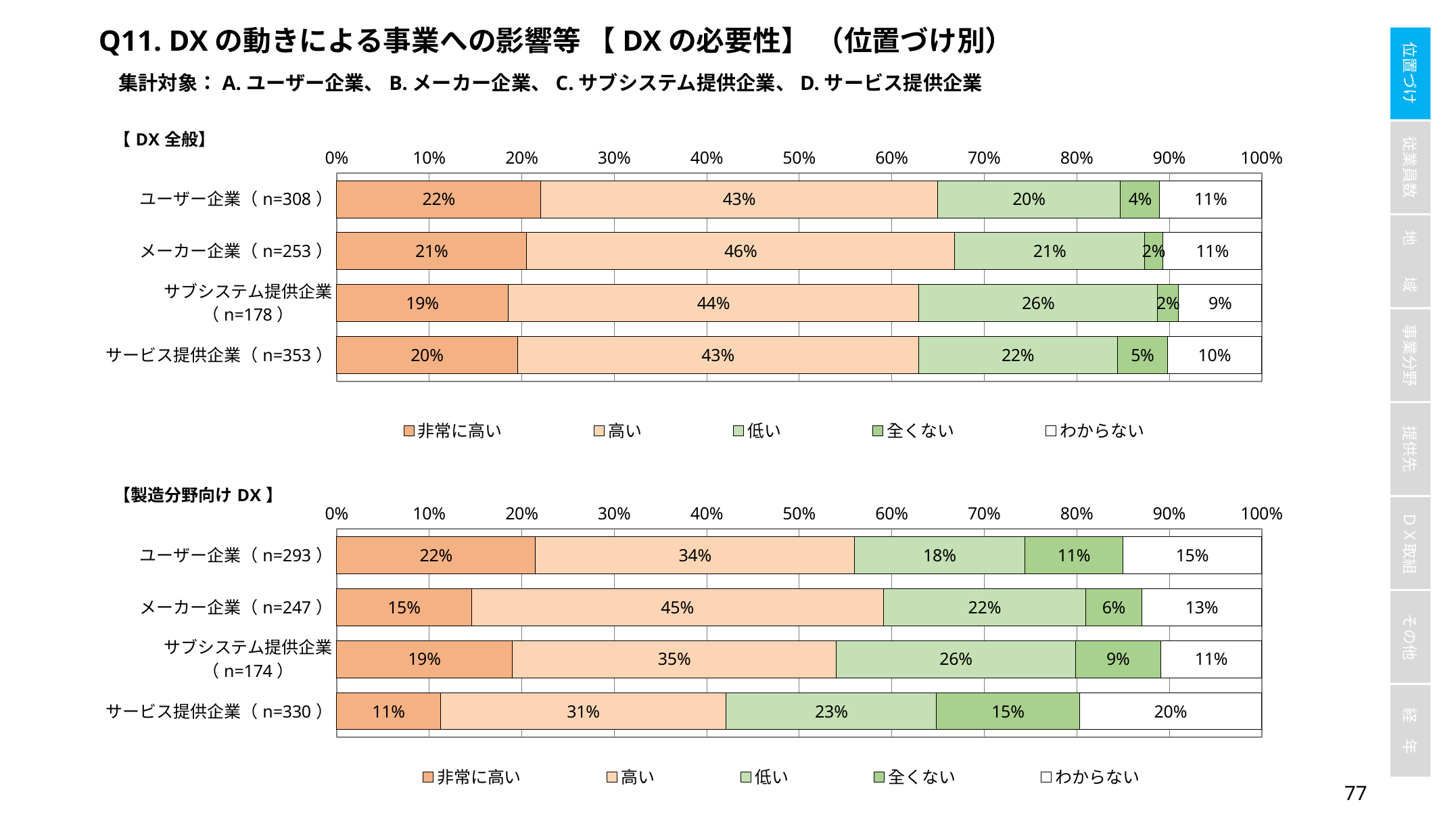
In the 【製造分野向けDX】 chart, what is the value of 全くない for ユーザー企業（n=293）? 11% How many categories are shown in the 【DX全般】 chart? 4 In the 【製造分野向けDX】 chart, which category has the highest value for 非常に高い? ユーザー企業（n=293） In the 【製造分野向けDX】 chart, which is larger: 低い for メーカー企業（n=247）or 低い for サブシステム提供企業（n=174）? サブシステム提供企業（n=174） What kind of chart is the 【DX全般】 chart? Stacked bar chart In the 【製造分野向けDX】 chart, what is the value of わからない for サービス提供企業（n=330）? 20% How many series does the legend of the 【製造分野向けDX】 chart list? 5 In the 【DX全般】 chart, what is the value of 低い for サブシステム提供企業（n=178）? 26% In the 【製造分野向けDX】 chart, which category has the lowest value for 高い? サービス提供企業（n=330） In the 【DX全般】 chart, what is the difference between the 高い values for メーカー企業（n=253）and ユーザー企業（n=308）? 3% In the 【製造分野向けDX】 chart, what is the combined value of 非常に高い and 高い for メーカー企業（n=247）? 60% In the 【DX全般】 chart, what is the value of 高い for ユーザー企業（n=308）? 43%